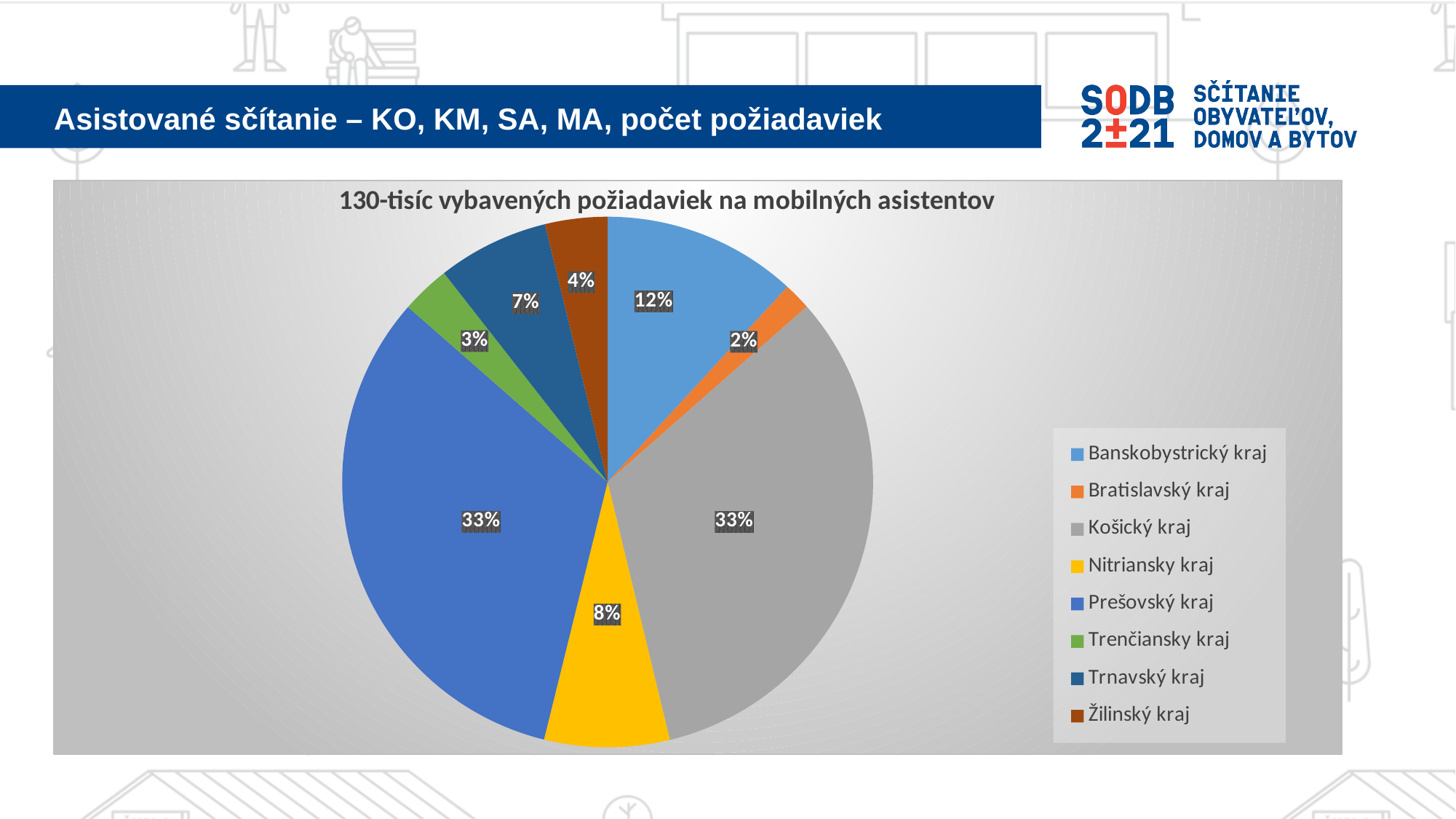
What share of the pie does Banskobystrický kraj have? 12% What kind of chart is shown on the slide? pie chart What share of the pie does Trnavský kraj have? 7% Which region has the smallest slice of the pie? Bratislavský kraj How many regions (kraje) does the legend list? 8 What is the difference in percentage points between the Banskobystrický kraj slice and the Nitriansky kraj slice? 4 What share of the pie does Bratislavský kraj have? 2% What is the chart's title? 130-tisíc vybavených požiadaviek na mobilných asistentov What colour is the slice for Nitriansky kraj? yellow Which is larger, the slice for Trnavský kraj or the slice for Trenčiansky kraj? Trnavský kraj